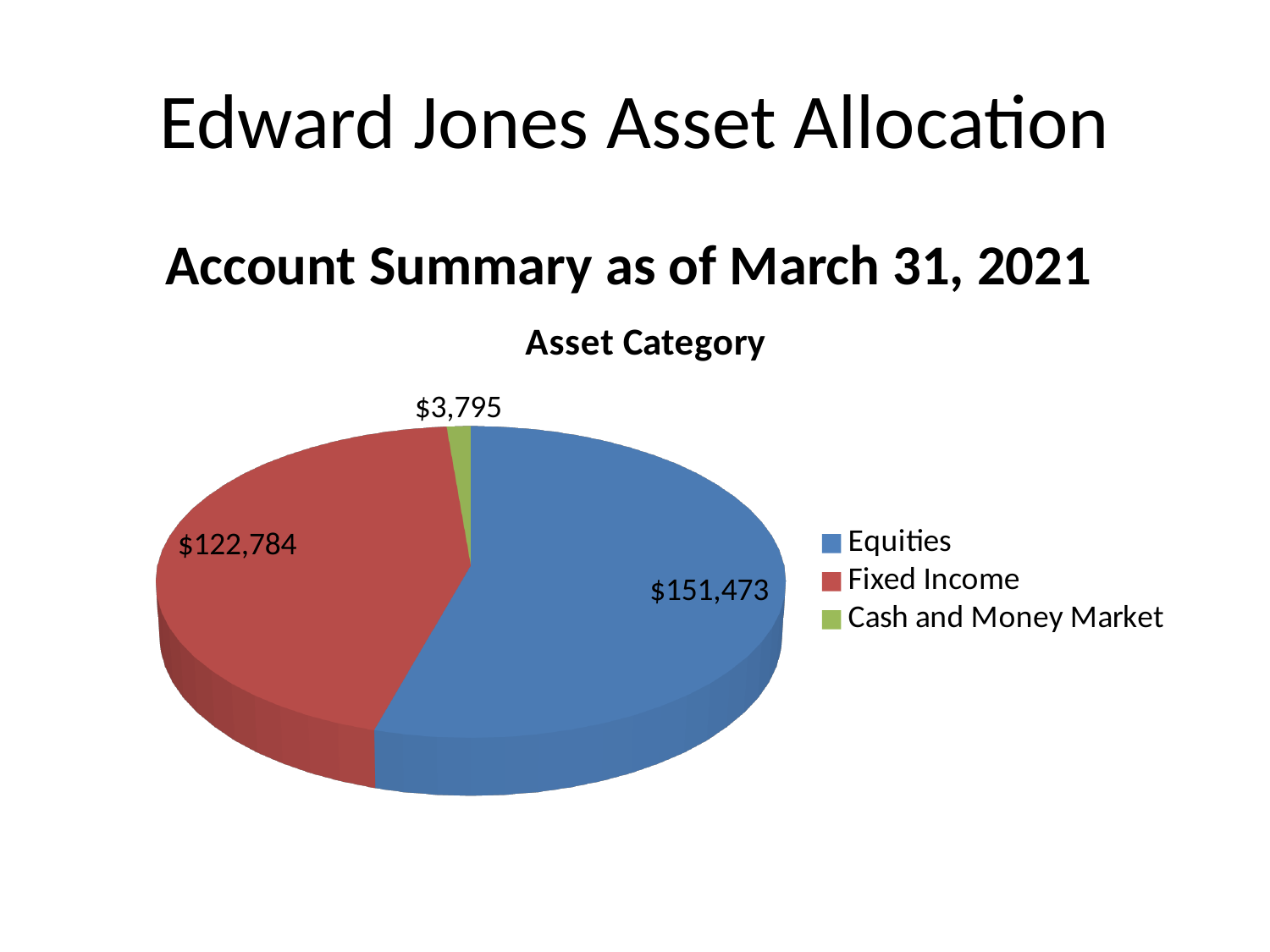
What type of chart is shown on the slide? Pie chart What is the difference between the Fixed Income value and the Cash and Money Market value? $118,989 What is the title of the chart on the slide? Asset Category Which asset category has the smallest slice in the pie chart? Cash and Money Market What is the value of the Equities slice in the Asset Category pie chart? $151,473 Which asset category has the largest slice in the pie chart? Equities What is the total of all three slices in the Asset Category pie chart? $278,052 What is the value of the Cash and Money Market slice in the Asset Category pie chart? $3,795 How many asset categories are shown in the pie chart? 3 What is the difference between the Equities value and the Fixed Income value? $28,689 What is the value of the Fixed Income slice in the Asset Category pie chart? $122,784 Which is larger, the Fixed Income slice or the Cash and Money Market slice? Fixed Income